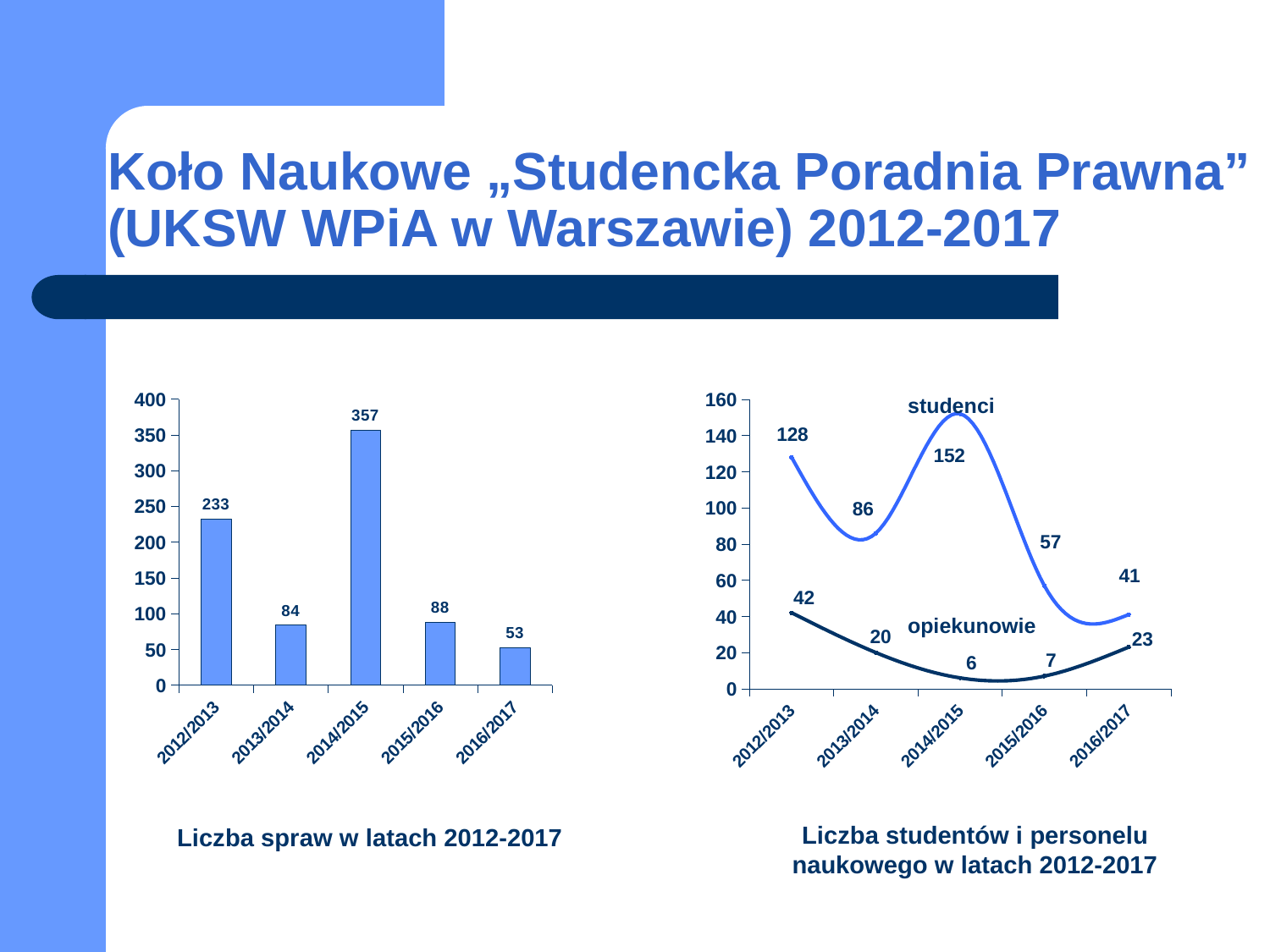
In the left chart (Liczba spraw w latach 2012-2017), which year has the lowest value? 2016/2017 In the right chart (Liczba studentów i personelu naukowego w latach 2012-2017), what is the value for opiekunowie in 2016/2017? 23 What kind of chart is the right chart (Liczba studentów i personelu naukowego w latach 2012-2017)? line chart In the left chart (Liczba spraw w latach 2012-2017), what is the difference between the values for 2014/2015 and 2012/2013? 124 In the right chart (Liczba studentów i personelu naukowego w latach 2012-2017), how many series are plotted? 2 In the left chart (Liczba spraw w latach 2012-2017), is the value for 2013/2014 greater or less than 100? less What kind of chart is the left chart (Liczba spraw w latach 2012-2017)? bar chart In the left chart (Liczba spraw w latach 2012-2017), what is the value for 2014/2015? 357 In the right chart (Liczba studentów i personelu naukowego w latach 2012-2017), what is the value for studenci in 2014/2015? 152 In the left chart (Liczba spraw w latach 2012-2017), how many years are shown on the x axis? 5 In the right chart (Liczba studentów i personelu naukowego w latach 2012-2017), in which year is the opiekunowie value lowest? 2014/2015 In the right chart (Liczba studentów i personelu naukowego w latach 2012-2017), what is the difference between studenci and opiekunowie in 2012/2013? 86